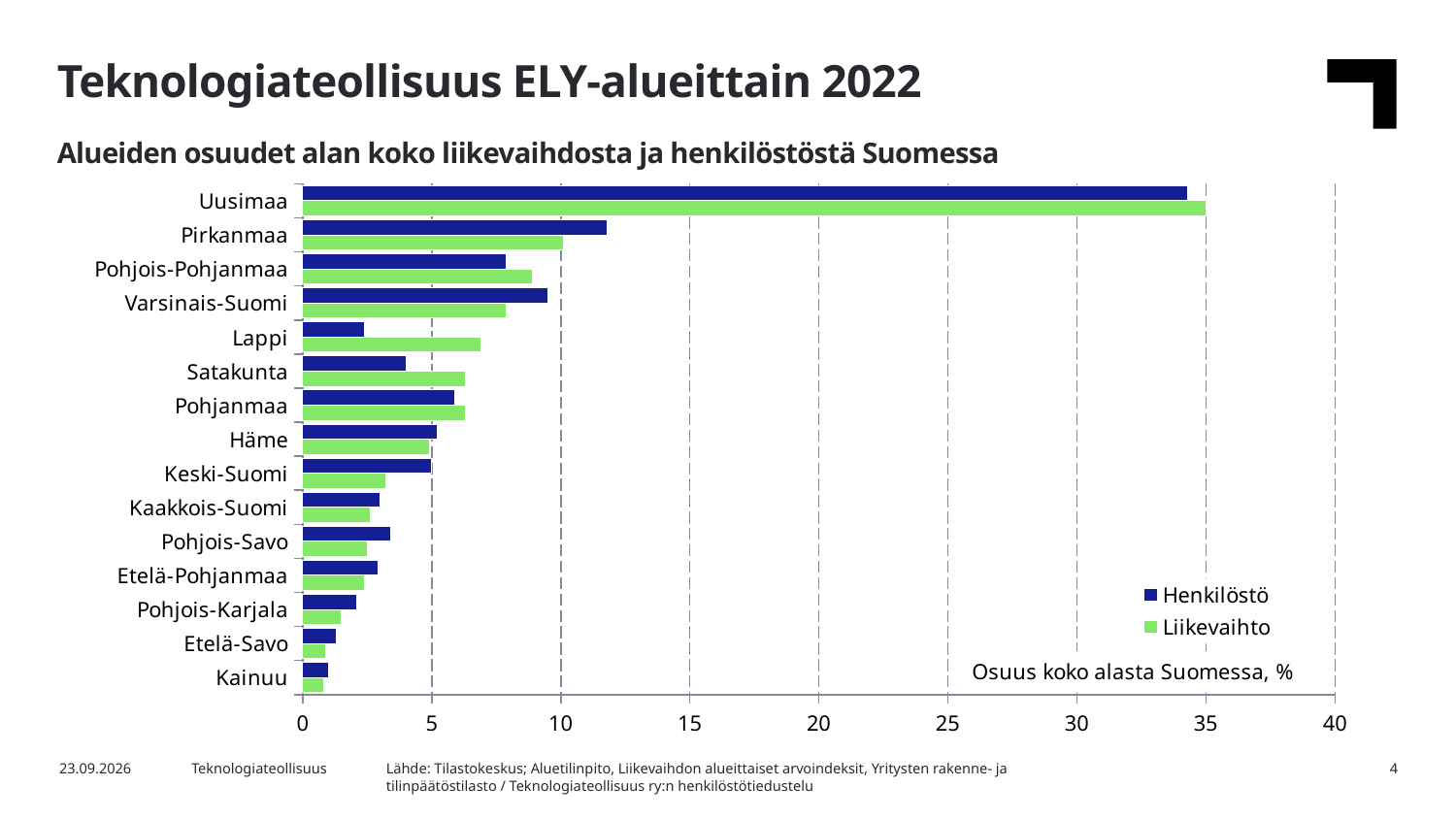
Which region has the larger Henkilöstö share: Varsinais-Suomi or Pohjois-Pohjanmaa? Varsinais-Suomi How many series does the legend list? 2 Is the Liikevaihto value for Lappi greater or less than 5? greater For Lappi, which is larger: Henkilöstö or Liikevaihto? Liikevaihto Is the Henkilöstö value for Varsinais-Suomi greater or less than 10? less What kind of chart is shown on the slide? bar chart Which region has the highest Henkilöstö share? Uusimaa Which colour represents the Liikevaihto series? green Is the Henkilöstö value for Uusimaa greater or less than 30? greater Which region has the highest Liikevaihto share? Uusimaa How many regions (categories) are plotted on the chart? 15